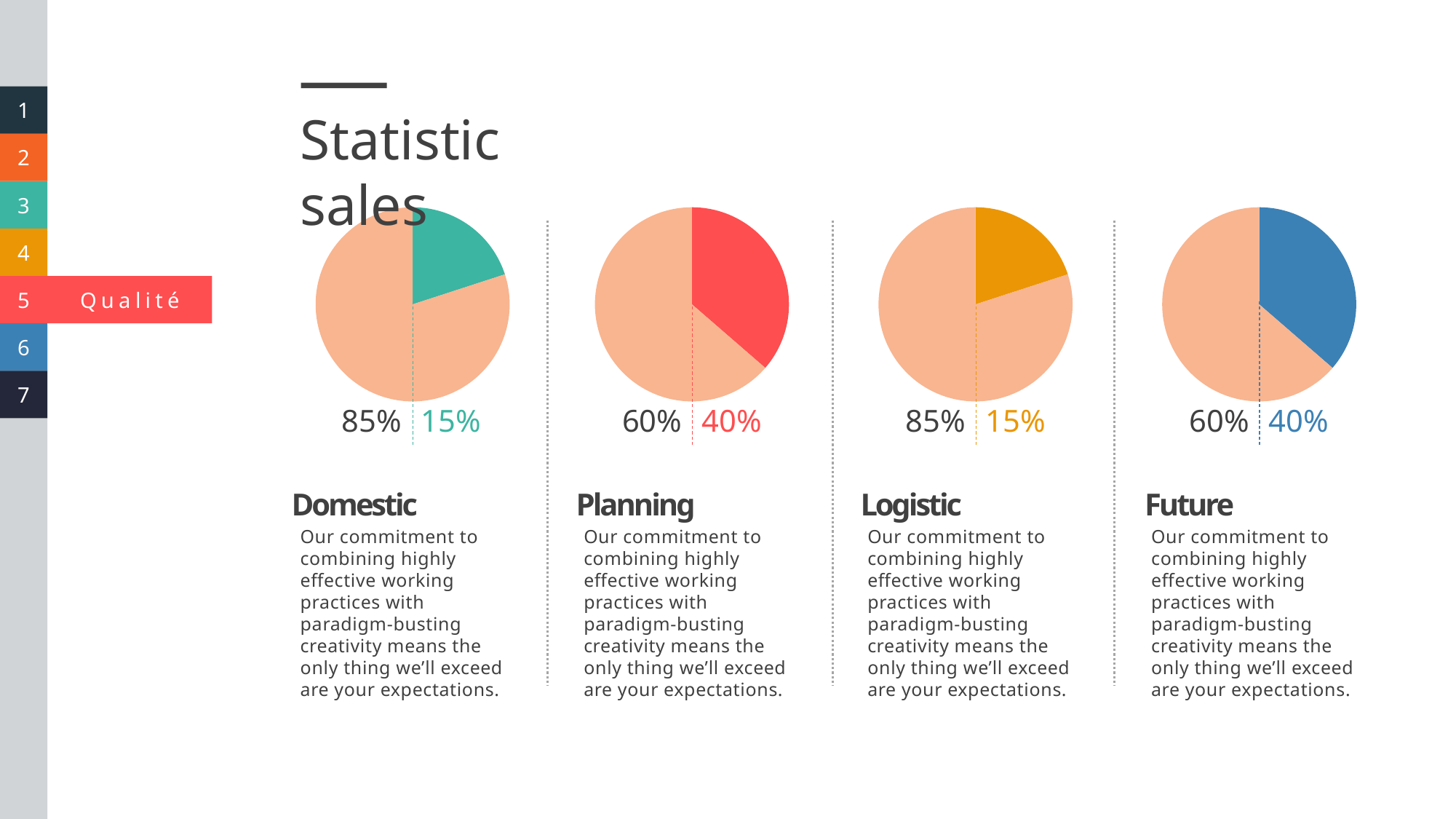
What kind of chart is used for the Planning section? Pie chart How many slices does the Future pie chart have? 2 What is the title of the slide containing the four pie charts? Statistic sales In the Logistic pie chart, what share does the orange slice represent? 15% In the Logistic pie chart, what is the difference between the two slices' percentages? 70% In the Domestic pie chart, what share does the teal slice represent? 15% How many pie charts are shown on the slide? 4 In the Domestic pie chart, what share does the larger peach slice represent? 85% In the Planning pie chart, what share does the red slice represent? 40% In the Future pie chart, what share does the blue slice represent? 40% In the Planning pie chart, what is the difference between the two slices' percentages? 20% Which is larger: the coloured slice in the Planning pie chart or the coloured slice in the Logistic pie chart? Planning